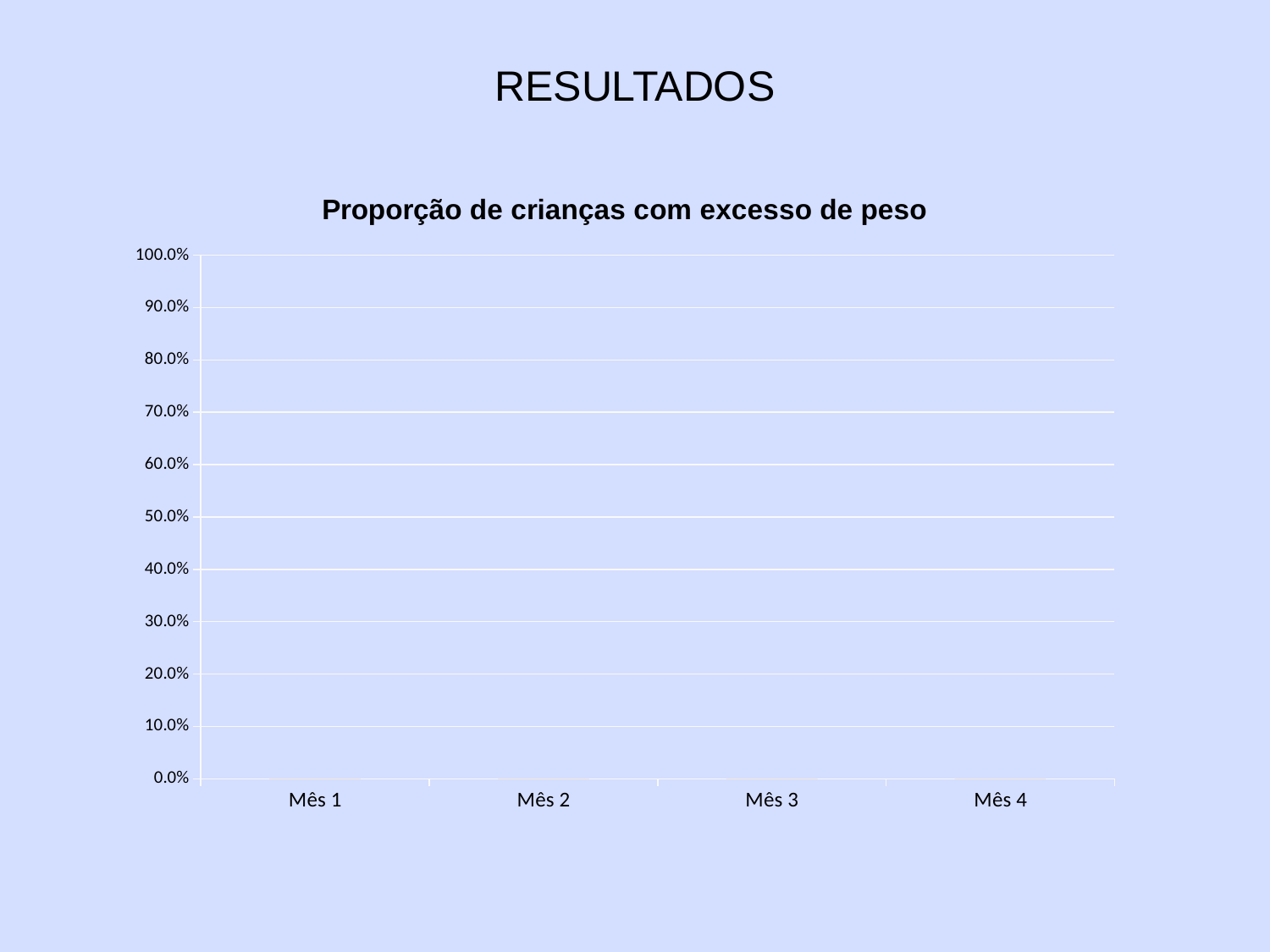
What is the title of the chart? Proporção de crianças com excesso de peso How many categories are shown on the x axis of the chart? 4 Is the value for Mês 2 greater or less than 50.0%? less What is the highest value shown on the y axis of the chart? 100.0% Is the value for Mês 1 greater or less than 10.0%? less Is the value for Mês 4 greater or less than 10.0%? less